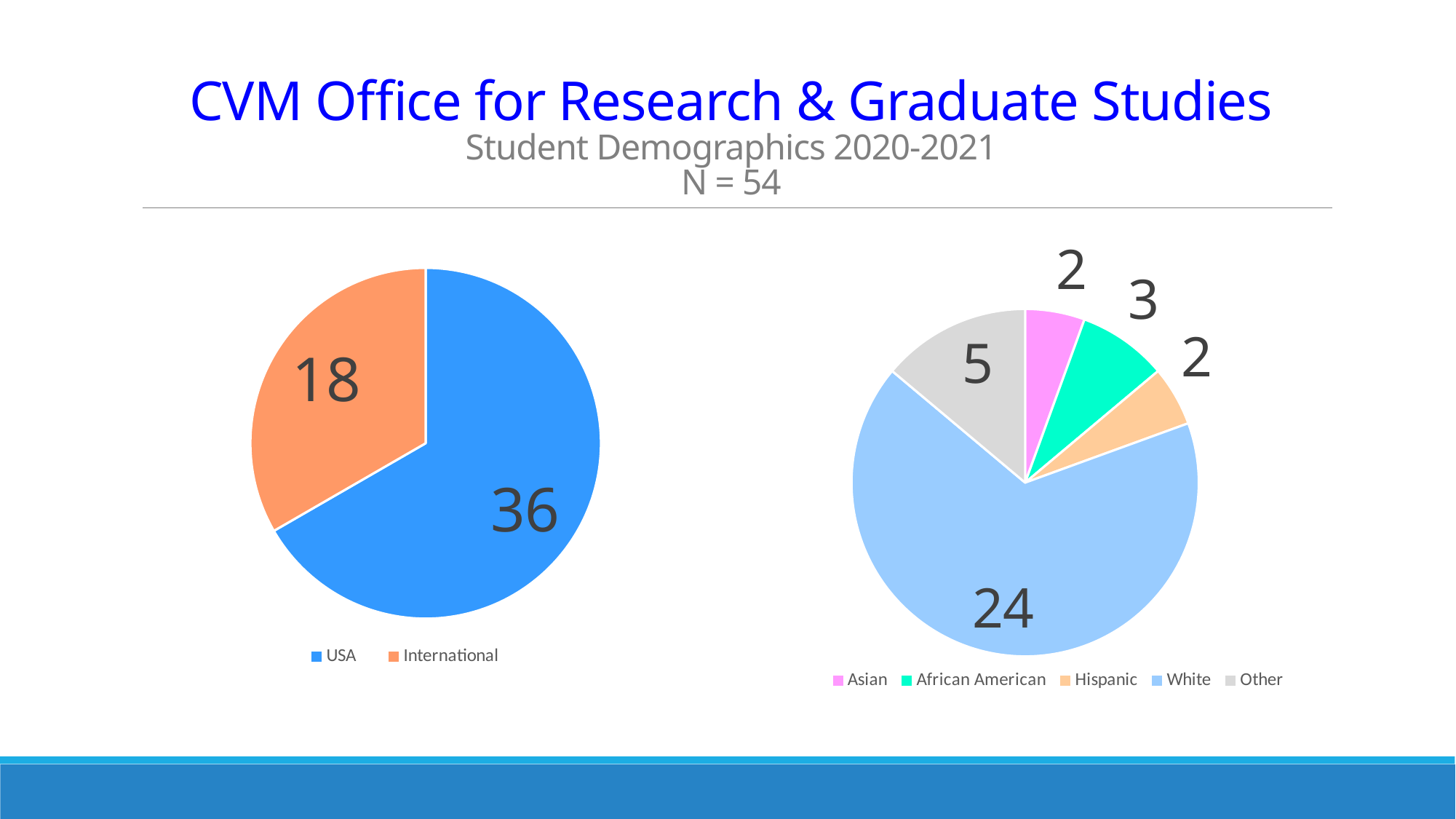
In the right pie chart, which category has the larger value, Other or African American? Other In the right pie chart, what is the value for African American? 3 In the right pie chart, what is the value for White? 24 In the right pie chart, which category has the largest slice? White In the left pie chart, what is the difference between the USA and International values? 18 What type of chart is the left chart? Pie chart In the right pie chart, what is the value for Other? 5 In the left pie chart, which colour represents International? Orange In the left pie chart, what is the value for International? 18 How many categories does the legend of the right pie chart list? 5 In the right pie chart, what is the difference between the White and Other values? 19 In the left pie chart, what is the value for USA? 36